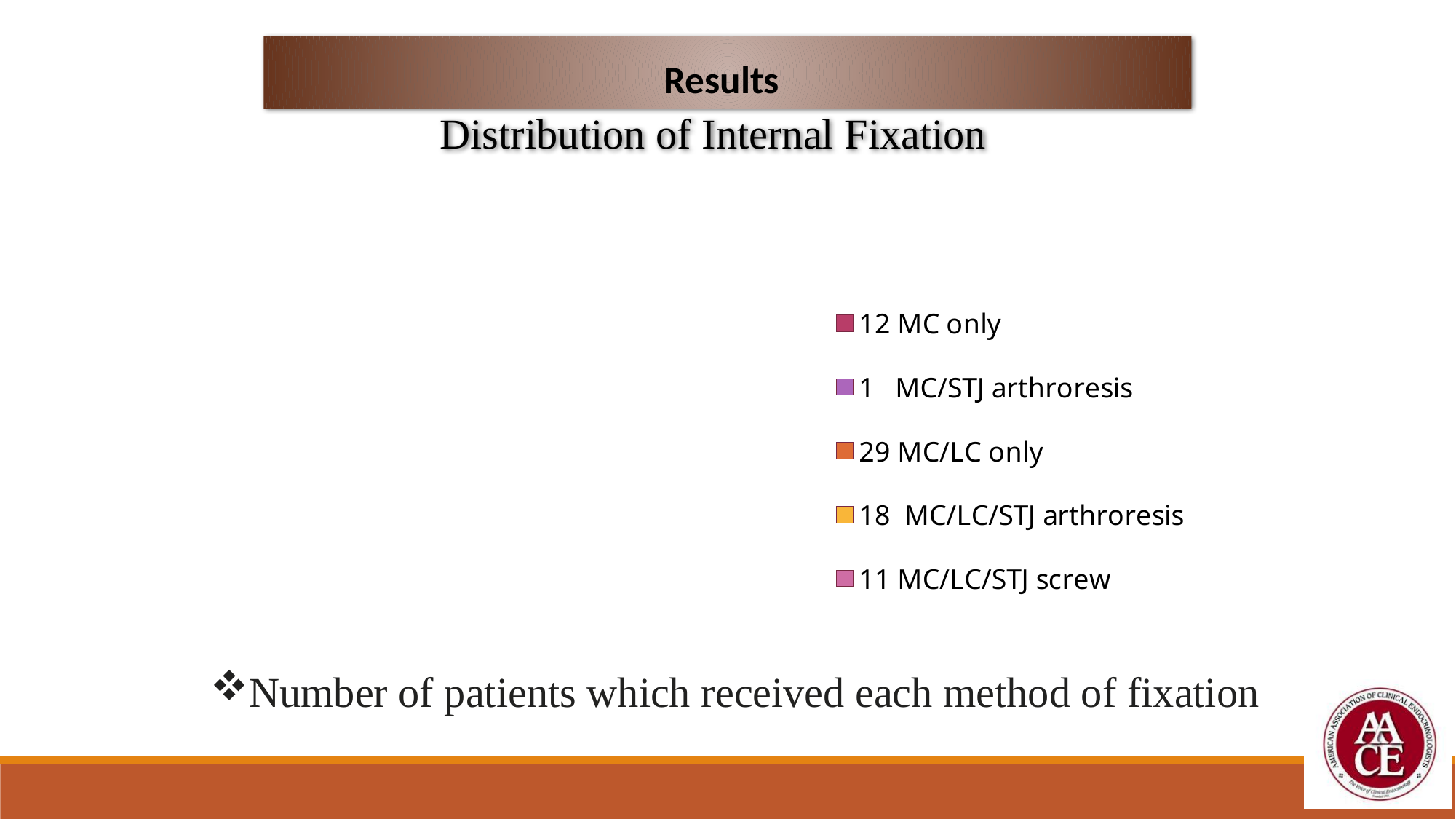
What is the title of the chart on this slide? Distribution of Internal Fixation According to the legend, how many patients received MC/LC only? 29 Which had more patients: MC only or MC/LC/STJ screw? MC only According to the legend, how many patients received MC/STJ arthroresis? 1 How many more patients received MC/LC only than MC/LC/STJ arthroresis? 11 According to the legend, how many patients received MC only? 12 According to the legend, how many patients received MC/LC/STJ arthroresis? 18 What is the total number of patients across all five fixation methods listed in the legend? 71 According to the legend, how many patients received MC/LC/STJ screw? 11 Which fixation method was received by the fewest patients? MC/STJ arthroresis Which fixation method was received by the most patients? MC/LC only How many fixation methods are listed in the legend? 5